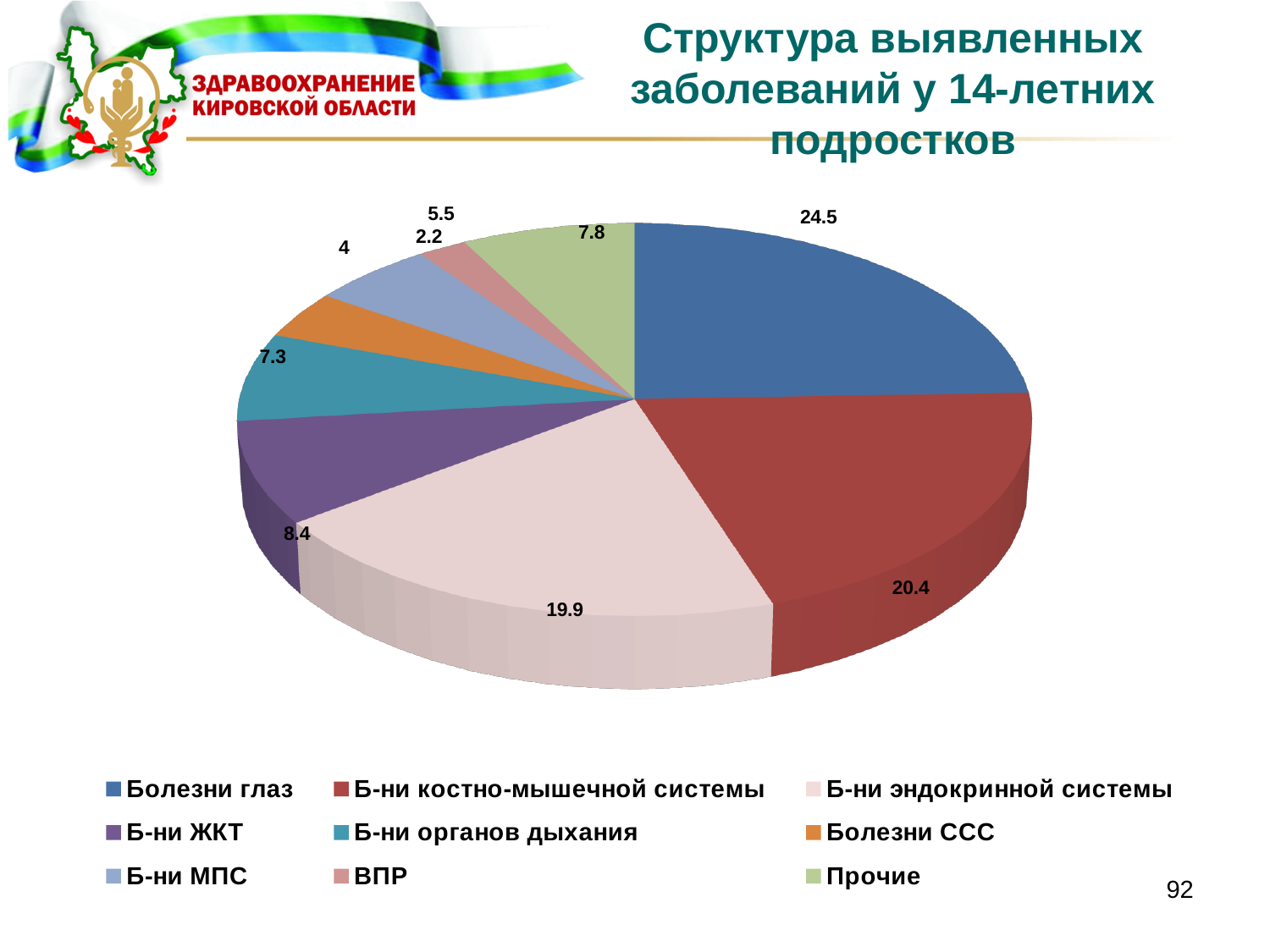
What is the value for Б-ни костно-мышечной системы? 20.4 What is the value for Болезни глаз? 24.5 What is the difference between the values for Болезни глаз and Б-ни костно-мышечной системы? 4.1 What is the value for Б-ни эндокринной системы? 19.9 What kind of chart is shown on the slide? pie chart What is the value for Б-ни ЖКТ? 8.4 Which category has the largest slice of the pie? Болезни глаз Which is larger, the value for Б-ни МПС or the value for Болезни ССС? Б-ни МПС How many categories does the legend list? 9 What is the value for Б-ни органов дыхания? 7.3 What is the value for ВПР? 2.2 Which category has the smallest slice of the pie? ВПР